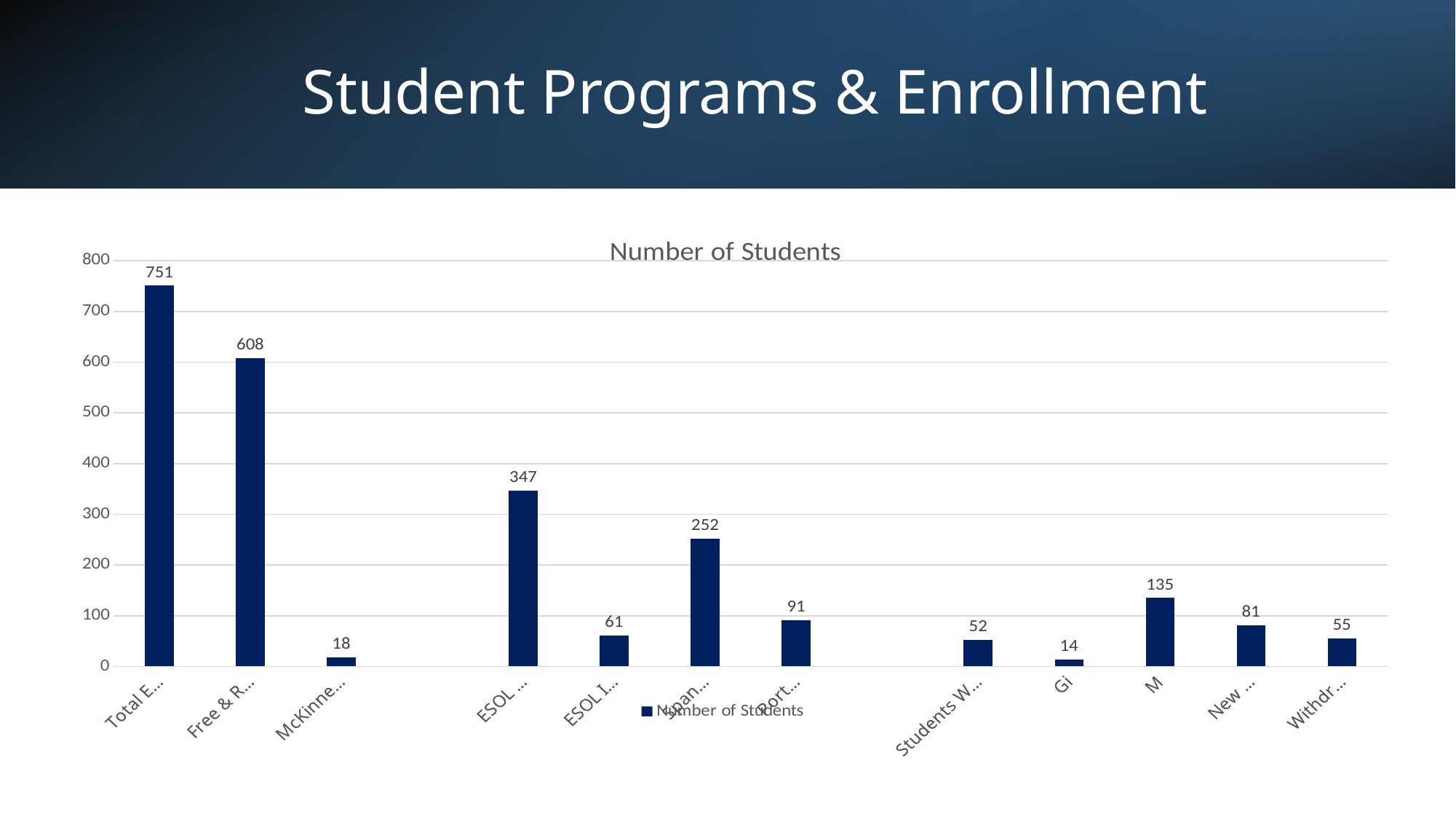
What is the value for the category labelled 'Gi'? 14 What is the value for the category labelled 'M'? 135 What is the value for the category whose label begins 'Students W'? 52 What is the difference between the first bar (751) and the second bar (608)? 143 Which is larger: the bar labelled 'ESOL ...' (347) or the bar labelled 'ESOL I...' (61)? ESOL ... (347) What is the value of the tallest bar in the chart? 751 What is the value of the shortest bar in the chart? 14 What type of chart is shown on the slide? bar chart What is the value for the category whose label begins 'Withdr'? 55 How many bars are plotted in the chart? 12 How many series does the legend list? 1 What is the title of the chart? Number of Students